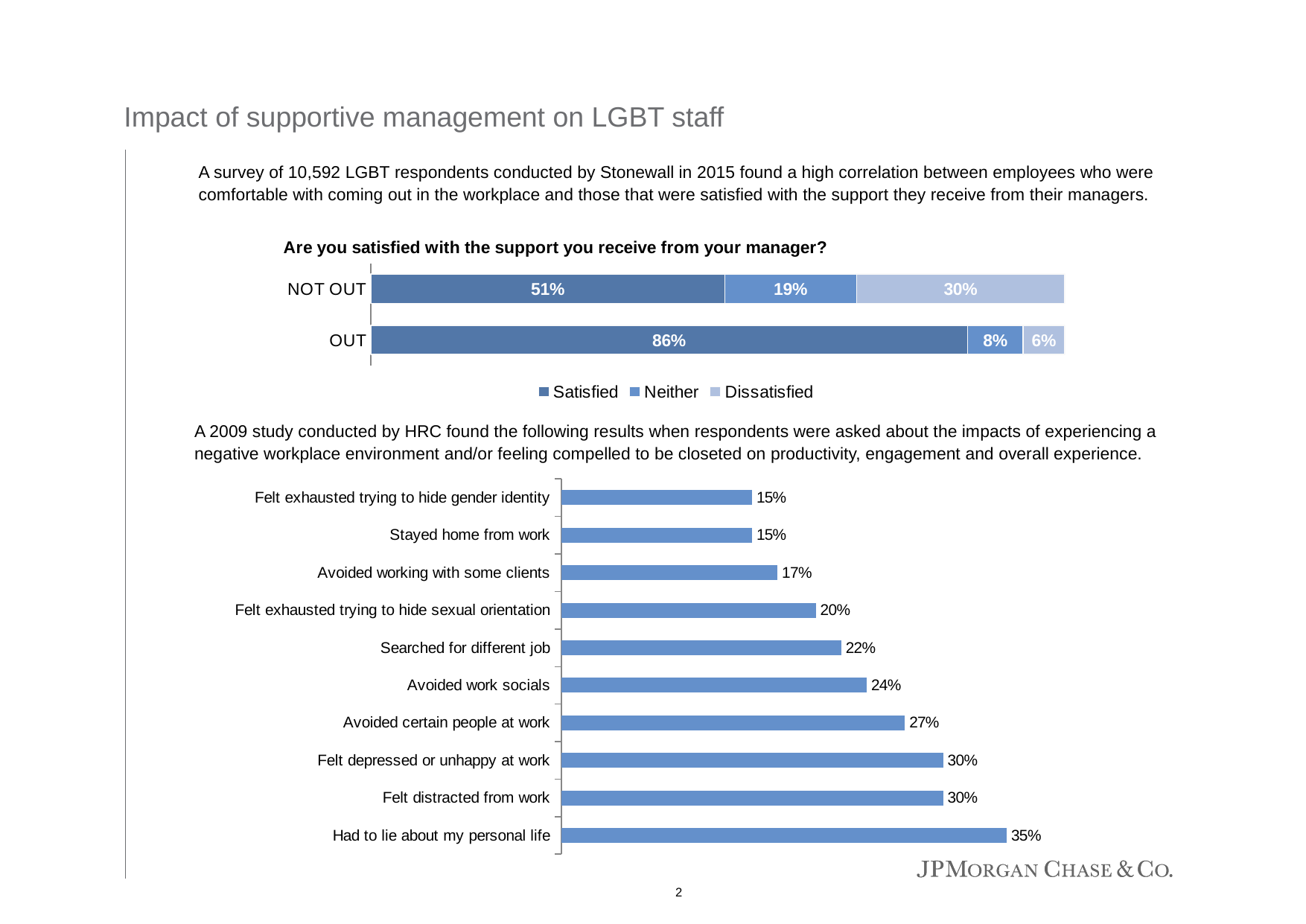
In the bottom chart, what is the difference between 'Searched for different job' and 'Avoided working with some clients'? 5% What type of chart is the bottom chart? Bar chart In the top chart 'Are you satisfied with the support you receive from your manager?', which group has the larger Neither share, OUT or NOT OUT? NOT OUT In the bottom chart, what is the value for 'Avoided work socials'? 24% In the top chart 'Are you satisfied with the support you receive from your manager?', what percentage of OUT respondents are Satisfied? 86% In the bottom chart, which category has the highest value? Had to lie about my personal life In the top chart 'Are you satisfied with the support you receive from your manager?', what is the total of the NOT OUT stacked bar? 100% In the top chart 'Are you satisfied with the support you receive from your manager?', what is the difference between the Satisfied share for OUT and for NOT OUT? 35% In the top chart 'Are you satisfied with the support you receive from your manager?', how many series does the legend list? 3 In the bottom chart, what percentage of respondents 'Had to lie about my personal life'? 35% In the top chart 'Are you satisfied with the support you receive from your manager?', what percentage of NOT OUT respondents are Dissatisfied? 30% In the bottom chart, how many categories are plotted? 10